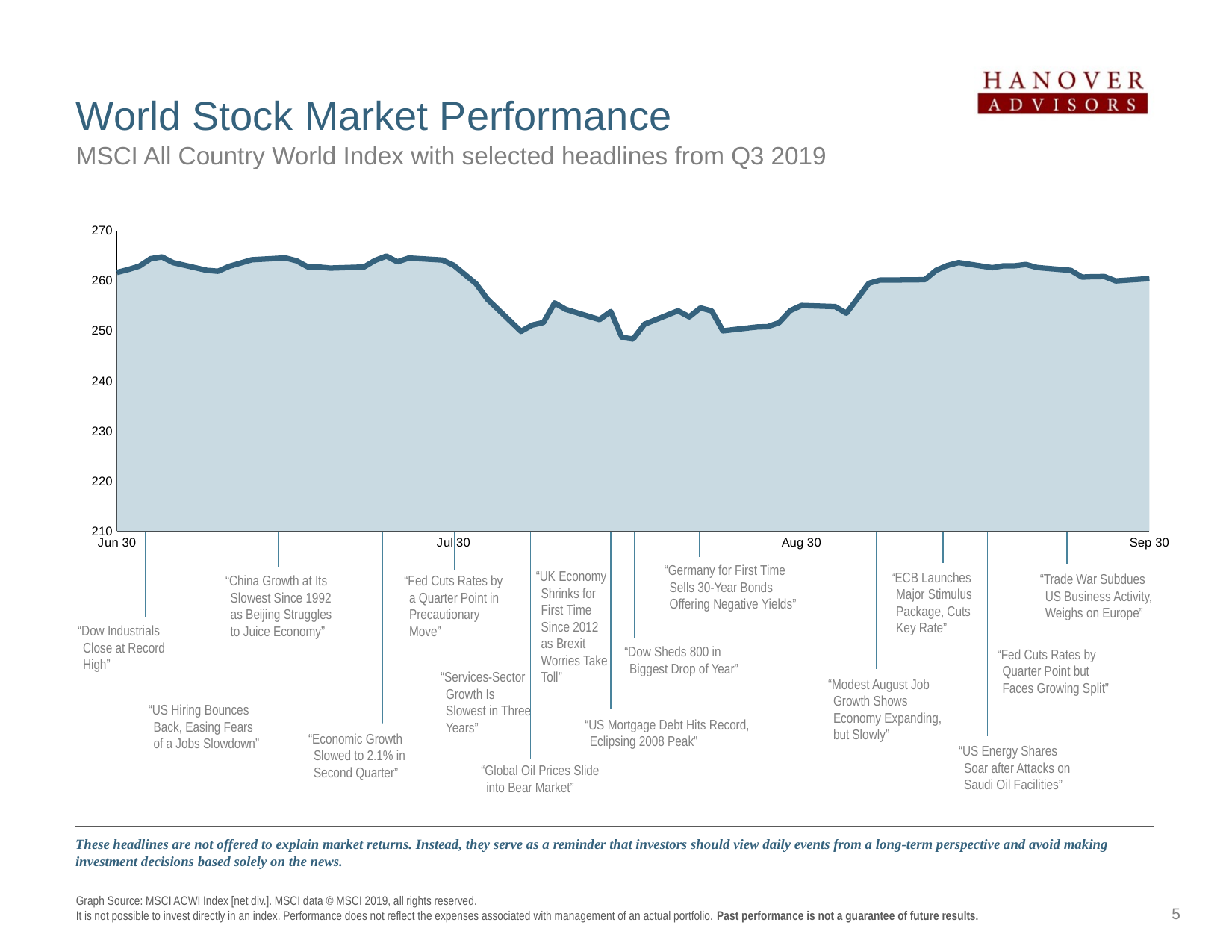
What is the title of the chart on the slide? World Stock Market Performance What kind of chart is shown on the slide? Area chart How many date labels are shown along the x axis? 4 What is the highest value shown on the y axis? 270 Is the highest point of the index in July greater or less than 260? greater Is the index value at Jun 30 greater or less than 250? greater Does the index rise or fall from mid-August to mid-September? rise Does the index rise or fall between Jul 30 and early August? fall Which index does the chart plot, according to the subtitle? MSCI All Country World Index Is the index value at Aug 30 greater or less than 250? greater